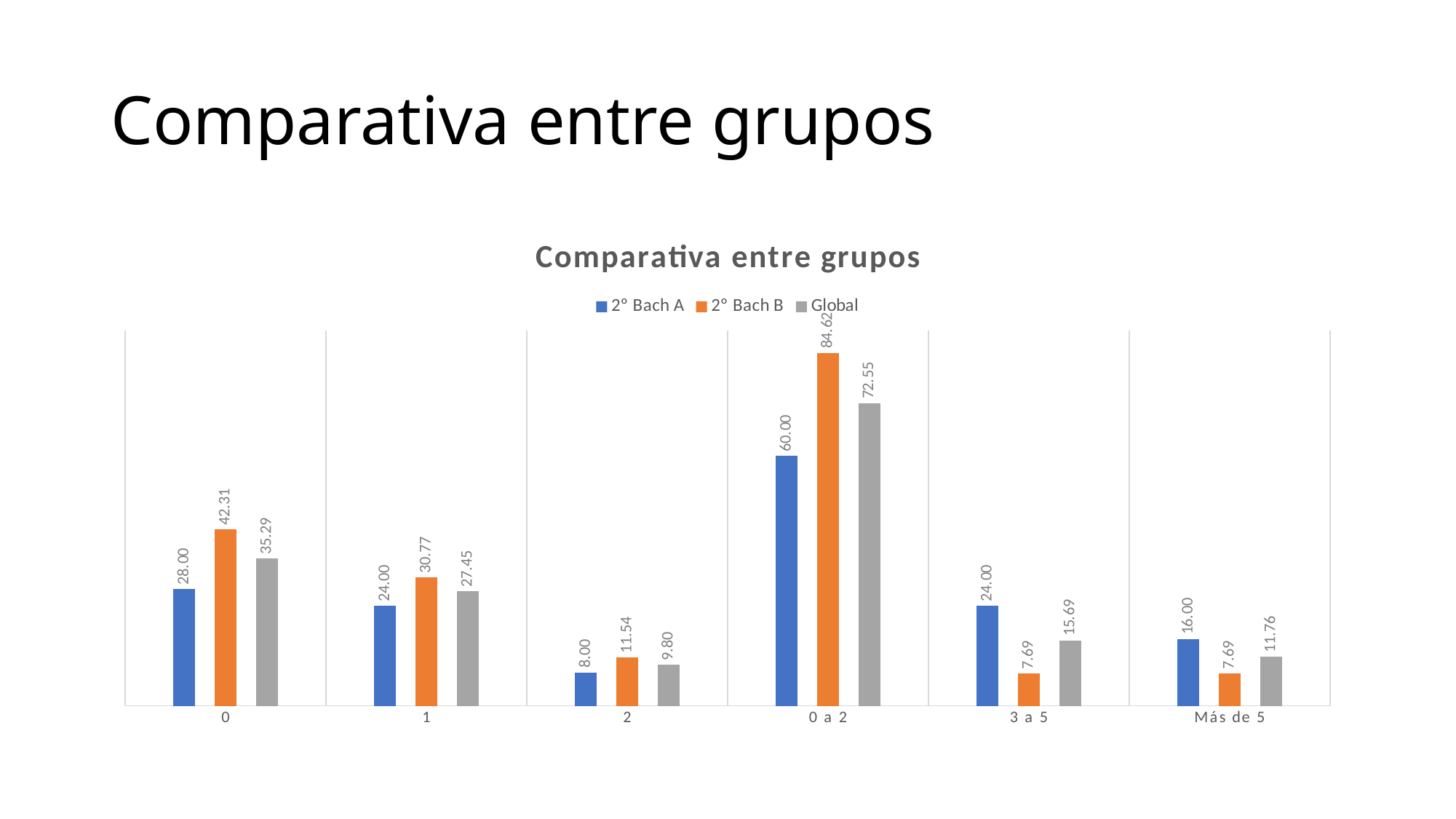
What is the title of the chart? Comparativa entre grupos Which category has the highest value for 2° Bach A? 0 a 2 What is the value for 2° Bach A in the category "2"? 8.00 What is the value for 2° Bach B in the category "0 a 2"? 84.62 What is the difference between the 2° Bach B and 2° Bach A values in the category "0"? 14.31 What is the Global value for the category "Más de 5"? 11.76 Which category has the lowest value for Global? 2 Which colour represents the Global series? Grey How many categories are shown on the x axis? 6 What kind of chart is shown on the slide? Bar chart How many series does the legend list? 3 In the category "3 a 5", which series has the larger value, 2° Bach A or 2° Bach B? 2° Bach A